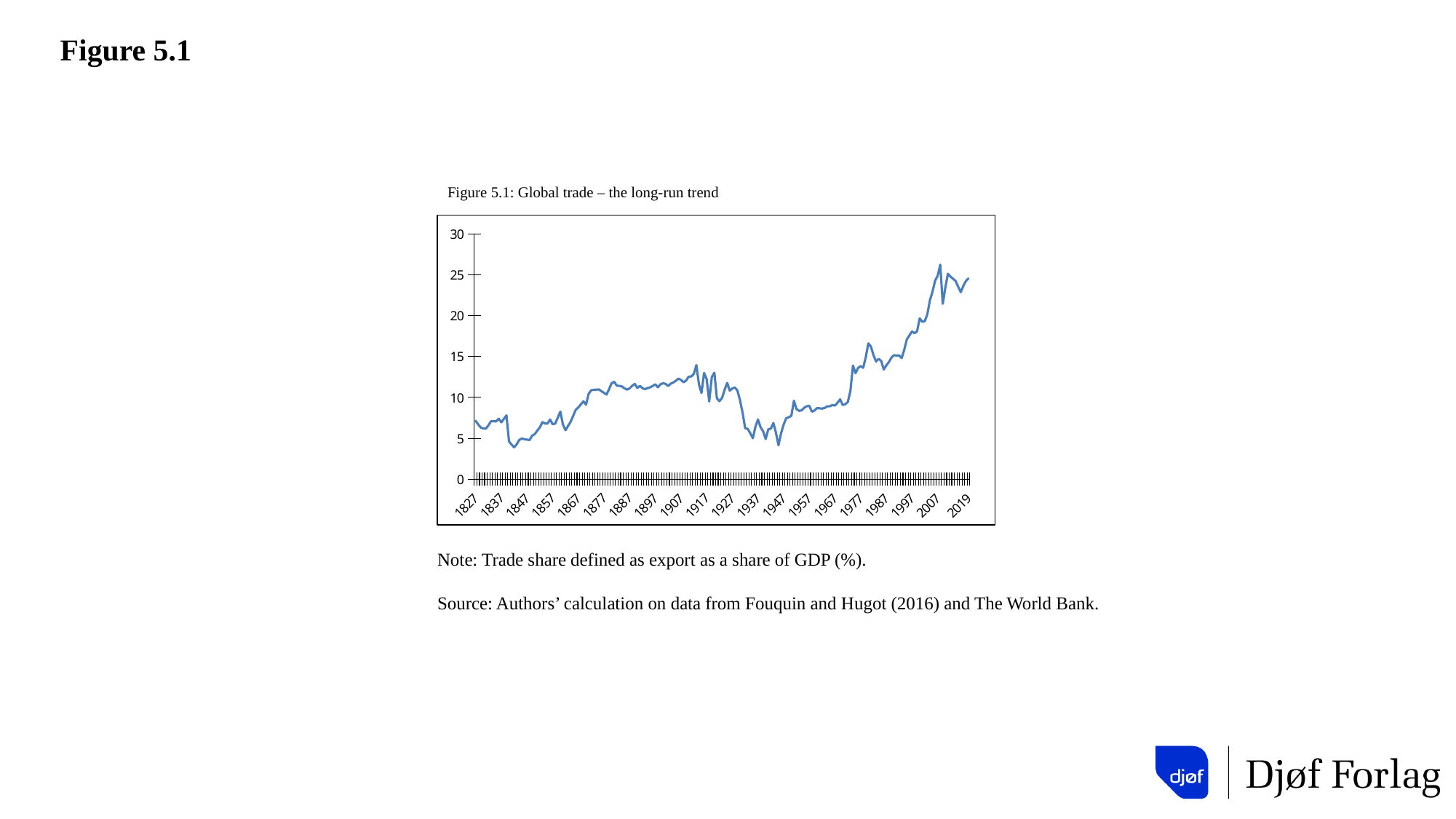
Is the value of the line at 1957 greater or less than 10? less What kind of chart is shown in Figure 5.1? line chart What is the title of the chart? Figure 5.1: Global trade – the long-run trend Is the value of the line at 1987 greater or less than 10? greater Does the line generally rise or fall between 1967 and 2007? rise Does the line generally rise or fall between 1917 and 1937? fall Is the value of the line at 1837 greater or less than 10? less What is the highest value shown on the vertical axis of the chart? 30